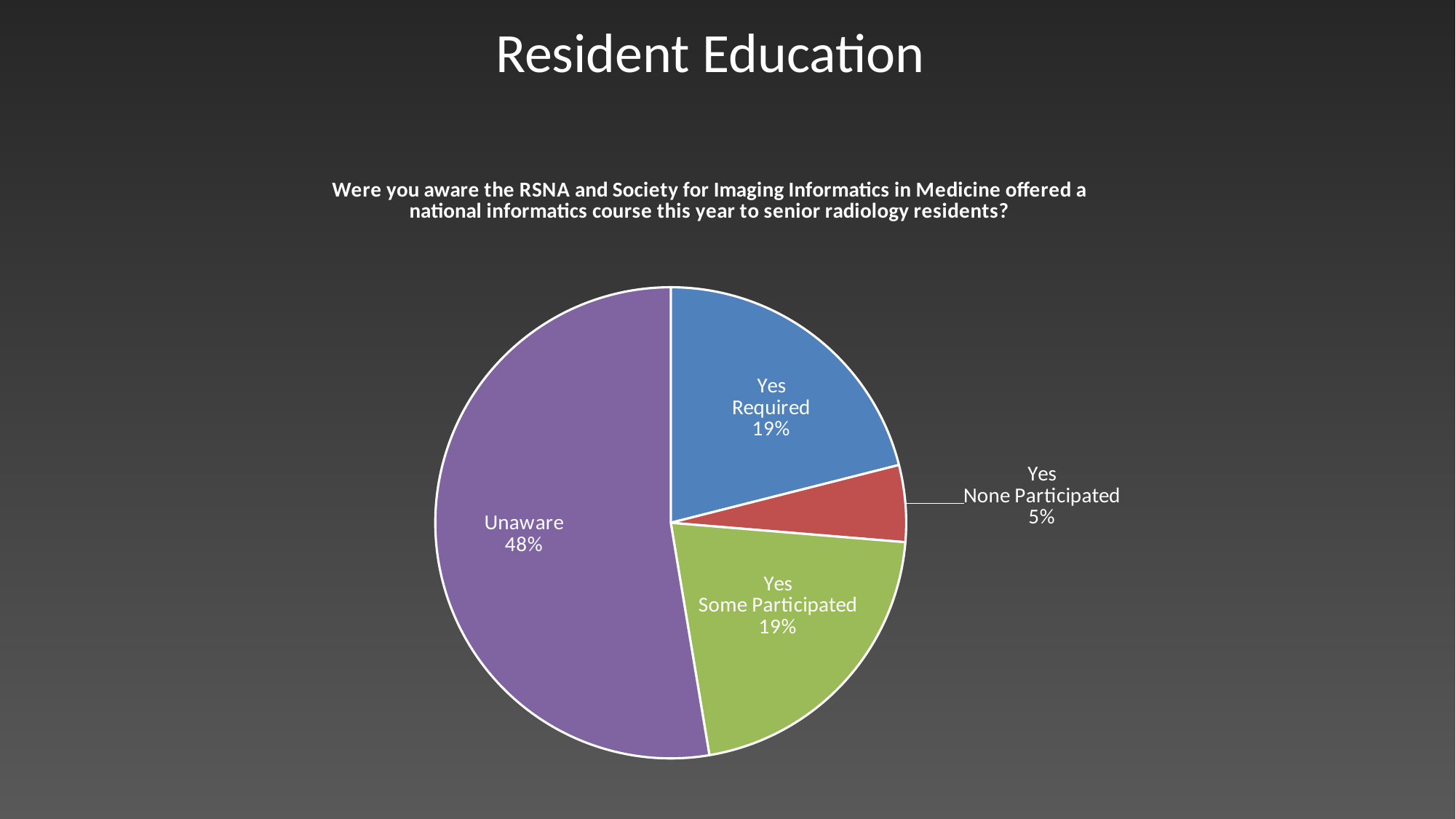
What share of respondents were Unaware? 48% How many slices does the pie chart have? 4 What share of respondents answered Yes, Some Participated? 19% What share of respondents answered Yes, Required? 19% What colour is the Unaware slice? purple Which is larger, the Unaware slice or the Yes, Some Participated slice? Unaware What is the title of the slide? Resident Education Which category has the smallest slice of the pie? Yes, None Participated What is the difference in percentage points between Unaware and Yes, Required? 29 What kind of chart is shown on the slide? pie chart Which category has the largest slice of the pie? Unaware